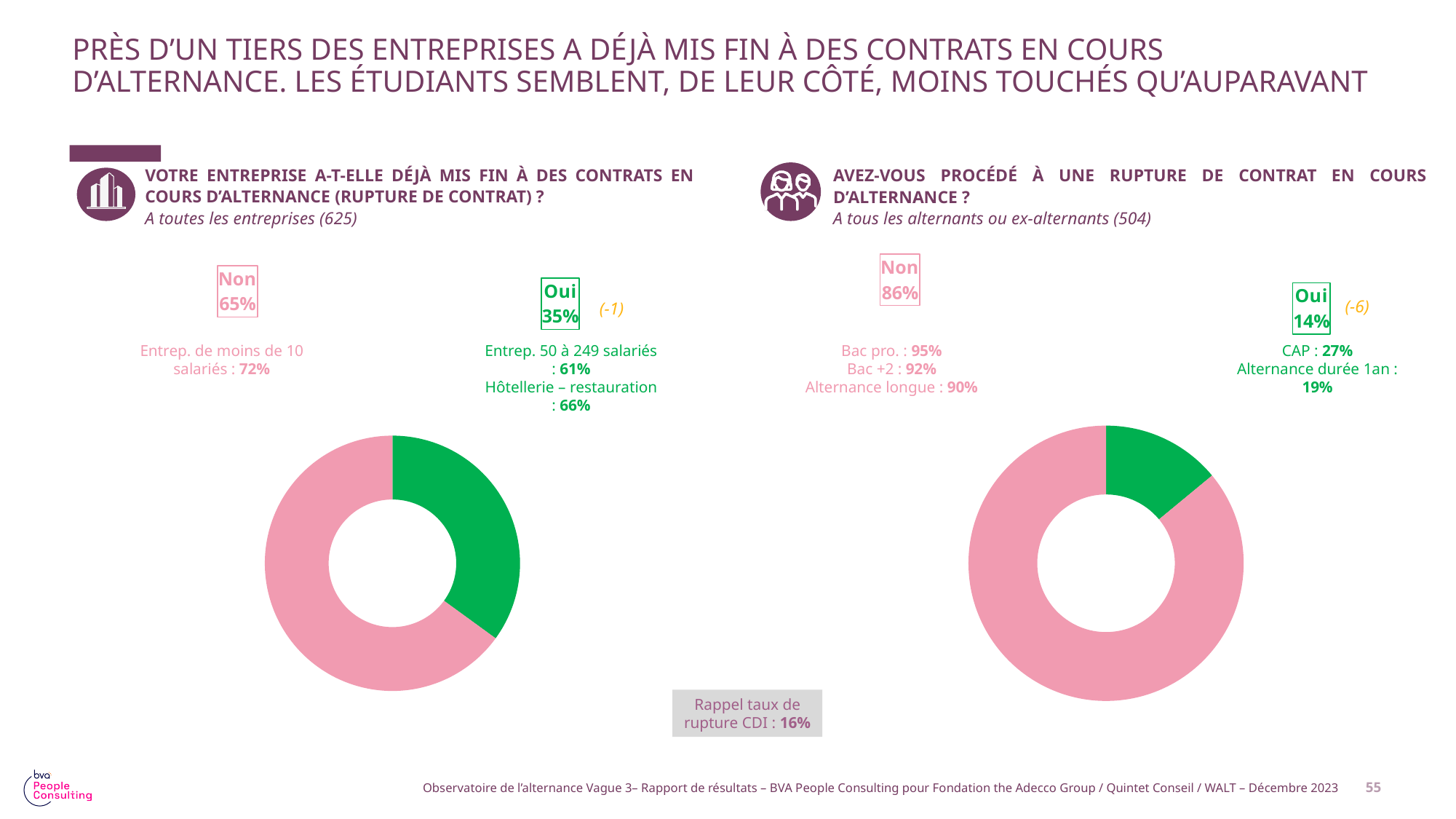
How many slices does the right chart (alternants) have? 2 Is the 'Oui' share in the left chart (entreprises) larger or smaller than the 'Oui' share in the right chart (alternants)? Larger In the left chart (entreprises), what is the difference in percentage points between 'Non' and 'Oui'? 30 In the right chart (alternants), what is the difference in percentage points between 'Non' and 'Oui'? 72 Which colour represents the 'Oui' answer in both charts? Green In the right chart (alternants), what share answered 'Oui'? 14% In the left chart (entreprises), what share of companies answered 'Oui'? 35% In the left chart (entreprises), which answer has the larger share, 'Oui' or 'Non'? Non What type of chart is used on the left side of the slide? Donut (pie) chart In the right chart (alternants), what share answered 'Non'? 86% In the left chart (entreprises), what share of companies answered 'Non'? 65% In the right chart (alternants), which answer has the smallest share? Oui